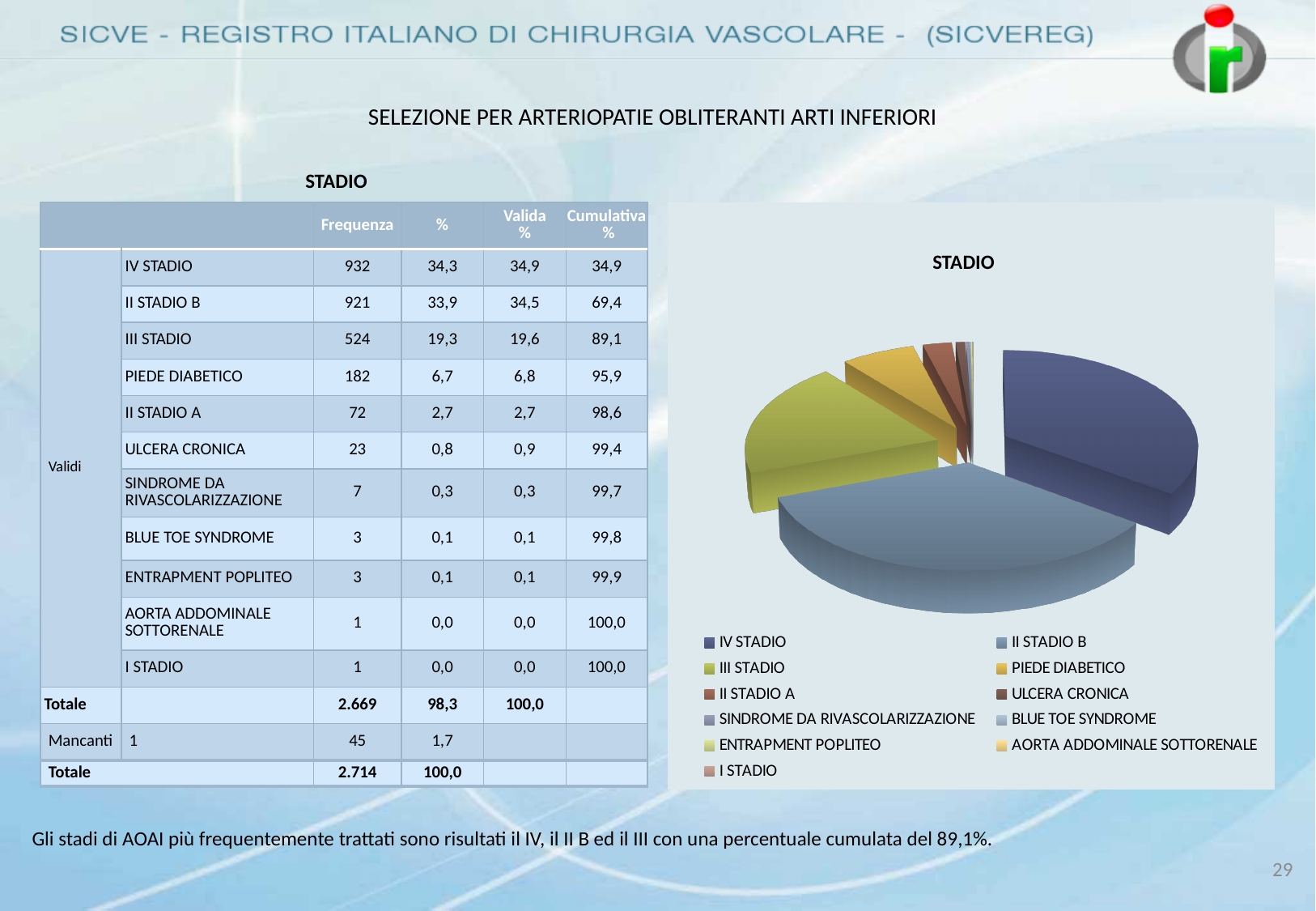
What colour represents IV STADIO in the pie chart? dark blue What percentage (%) is shown for PIEDE DIABETICO? 6,7 What is the total frequency of the valid (Validi) cases? 2.669 Which has a smaller frequency, II STADIO A or ULCERA CRONICA? ULCERA CRONICA What is the valid percentage (Valida %) share for IV STADIO? 34,9 What kind of chart is shown on the slide? pie chart What is the difference in frequency between IV STADIO and II STADIO B? 11 How many categories does the legend of the pie chart list? 11 What is the title of the pie chart? STADIO Which has a larger frequency, III STADIO or PIEDE DIABETICO? III STADIO Which category has the largest slice in the pie chart? IV STADIO What is the frequency (Frequenza) for III STADIO? 524